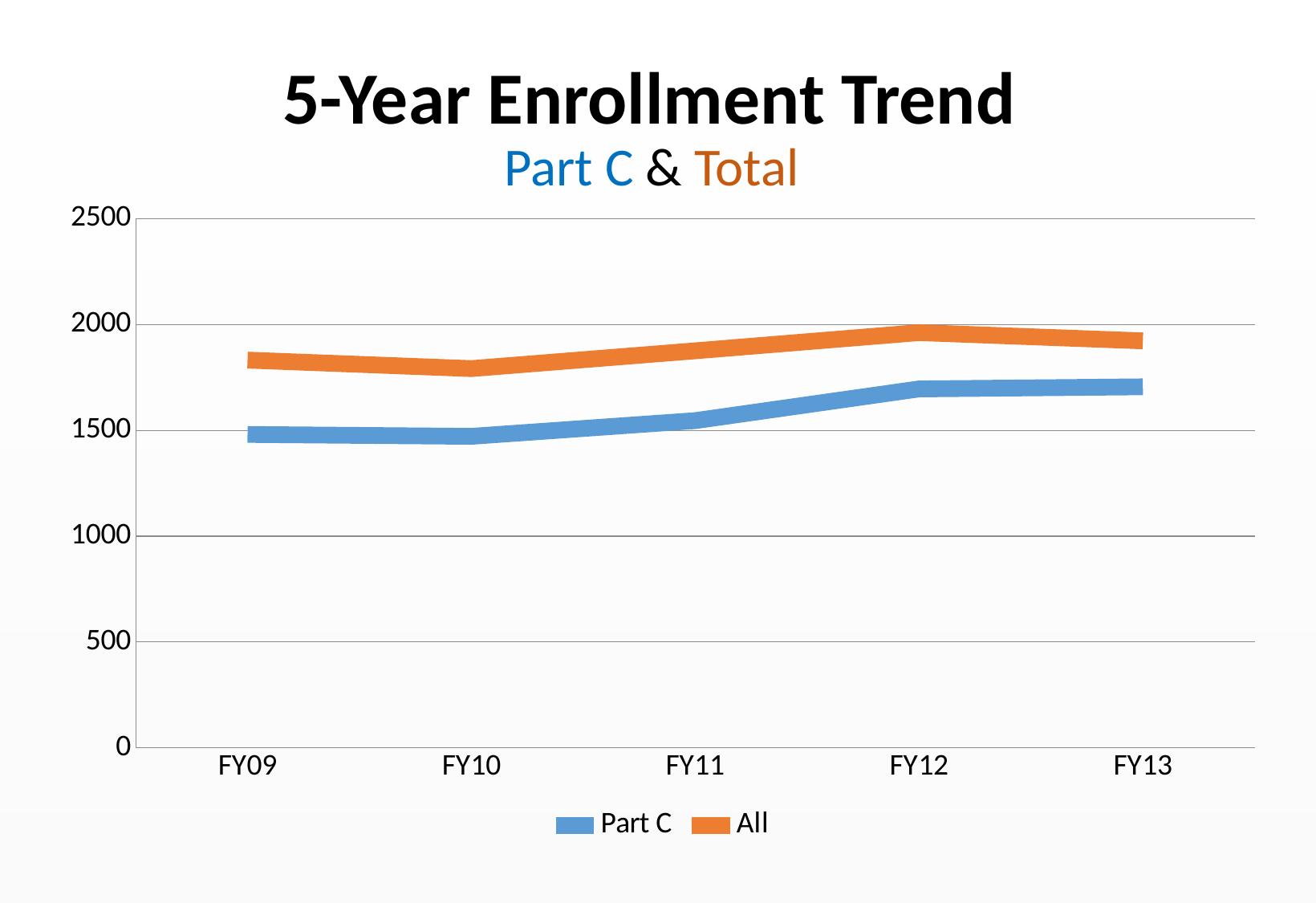
In FY11, which series has the larger value, Part C or All? All How many series does the legend list? 2 Does the Part C series rise or fall overall from FY09 to FY13? rise What kind of chart is shown on the slide? line chart Is the value for Part C in FY12 greater or less than 1500? greater What is the title of the chart? 5-Year Enrollment Trend Which series is shown in orange according to the legend? All In which fiscal year is the All series at its lowest? FY10 In which fiscal year is the All series at its highest? FY12 Is the value for All in FY09 greater or less than 1500? greater How many fiscal years are plotted along the x axis? 5